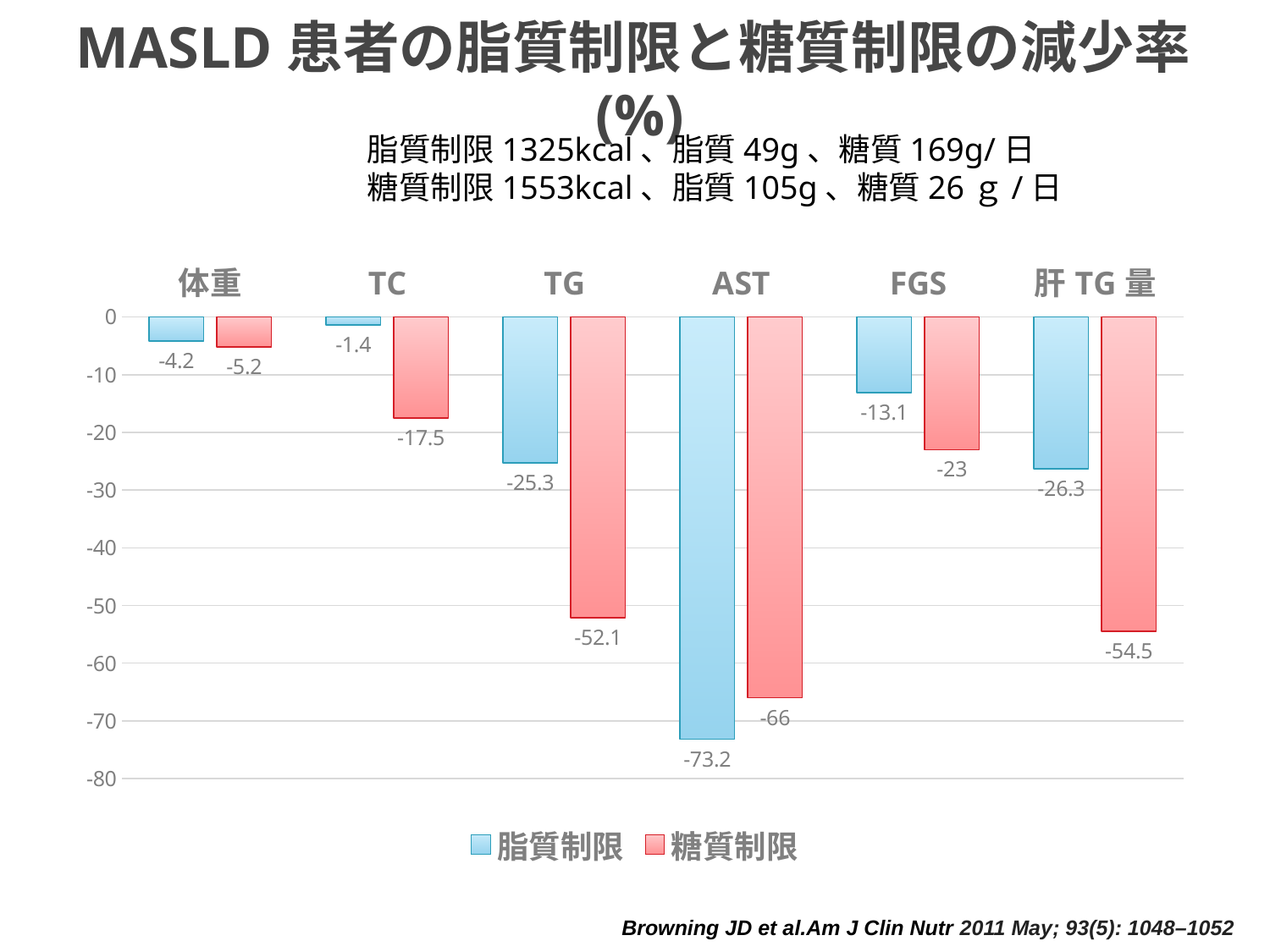
What is the difference between the 糖質制限 and 脂質制限 values in the TG category? 26.8 In which category does the 糖質制限 series have its most negative value? AST How many series does the legend list? 2 In the AST category, which series has the more negative value, 脂質制限 or 糖質制限? 脂質制限 What is the value for 脂質制限 in the 体重 category? -4.2 What kind of chart is shown on the slide? bar chart What is the value for 糖質制限 in the TC category? -17.5 How many categories are shown on the x axis? 6 In which category does the 脂質制限 series have the value closest to zero? TC Which colour represents the 糖質制限 series? red What is the value for 糖質制限 in the 肝 TG 量 category? -54.5 What is the value for 脂質制限 in the AST category? -73.2